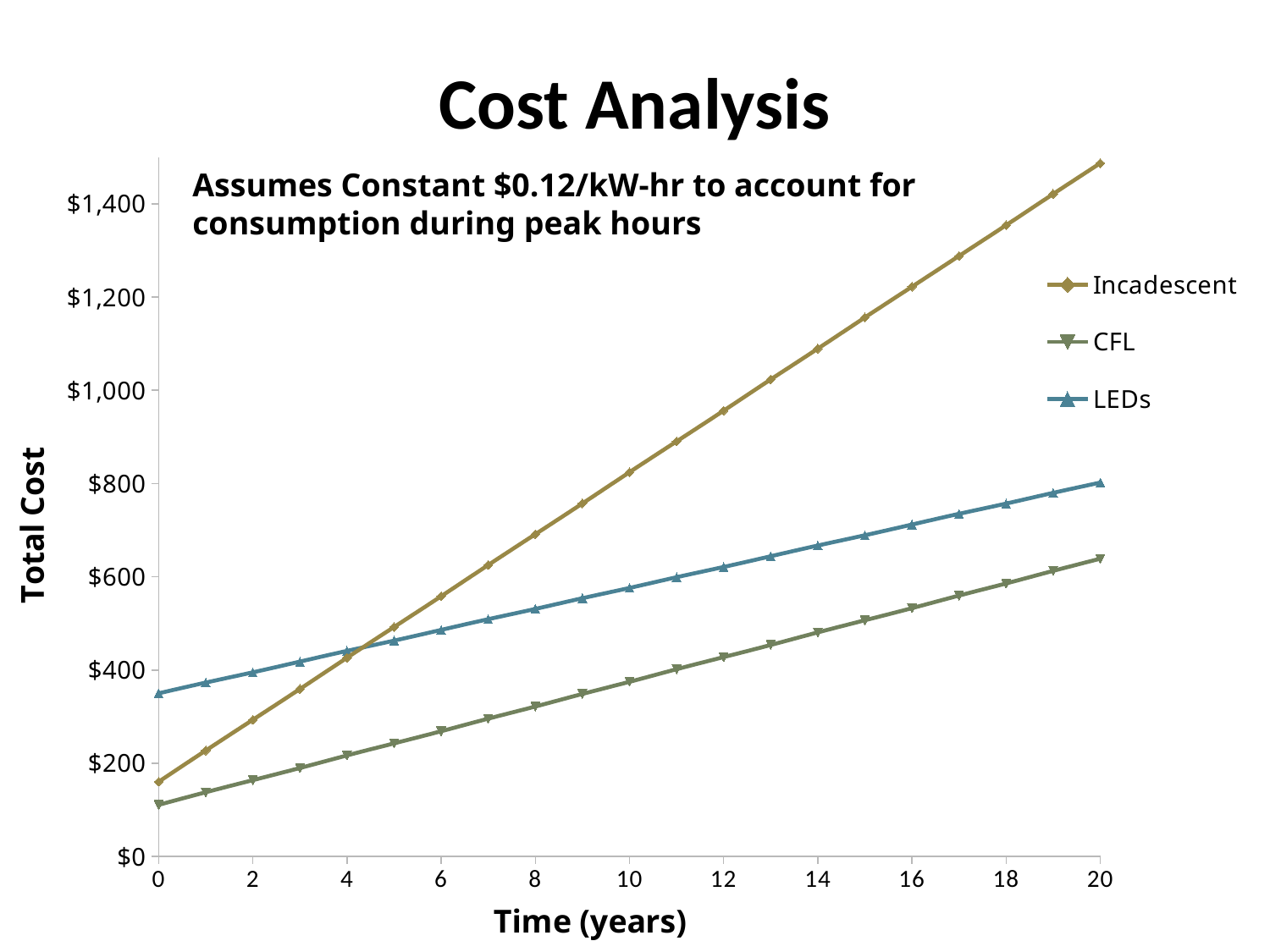
Does the total cost for Incadescent rise or fall as time increases? rise How many series does the legend list? 3 At year 10, which is larger: the total cost for Incadescent or for LEDs? Incadescent Which series has the lowest total cost at year 0? CFL What kind of chart is shown on the slide? line chart Is the value for LEDs at year 0 greater or less than $200? greater What is the label of the x axis? Time (years) At year 2, which is larger: the total cost for LEDs or for Incadescent? LEDs Is the value for Incadescent at year 20 greater or less than $1,400? greater What is the title of the chart? Cost Analysis Is the value for CFL at year 20 greater or less than $800? less Which series has the highest total cost at year 20? Incadescent